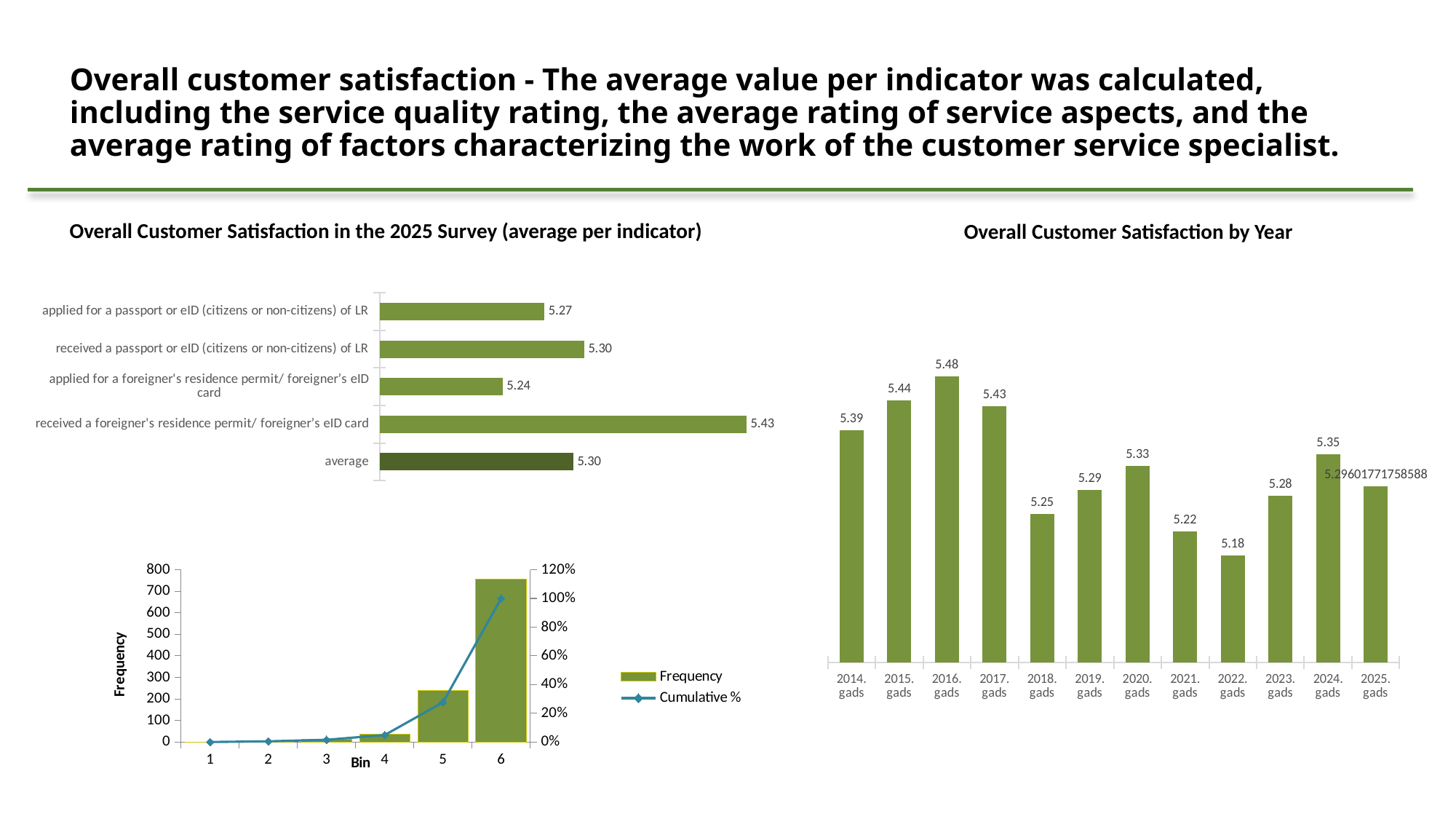
In the 'Overall Customer Satisfaction in the 2025 Survey (average per indicator)' chart, what is the difference between 'received a foreigner's residence permit/ foreigner's eID card' and 'applied for a passport or eID (citizens or non-citizens) of LR'? 0.16 In the 'Overall Customer Satisfaction by Year' chart, what is the difference between the values for 2016. gads and 2022. gads? 0.30 In the 'Overall Customer Satisfaction by Year' chart, which year has the highest value? 2016. gads In the histogram chart at the bottom left, is the Frequency value for bin 6 greater or less than 700? greater In the 'Overall Customer Satisfaction by Year' chart, which is larger, the value for 2020. gads or 2021. gads? 2020. gads How many years are shown in the 'Overall Customer Satisfaction by Year' chart? 12 In the 'Overall Customer Satisfaction by Year' chart, which year has the lowest value? 2022. gads What kind of chart is the 'Overall Customer Satisfaction in the 2025 Survey (average per indicator)' chart? bar chart In the histogram chart at the bottom left, how many series does the legend list? 2 In the 'Overall Customer Satisfaction in the 2025 Survey (average per indicator)' chart, what is the value for 'received a foreigner's residence permit/ foreigner's eID card'? 5.43 In the 'Overall Customer Satisfaction by Year' chart, what is the value for 2018. gads? 5.25 In the 'Overall Customer Satisfaction in the 2025 Survey (average per indicator)' chart, which category has the lowest value? applied for a foreigner's residence permit/ foreigner's eID card